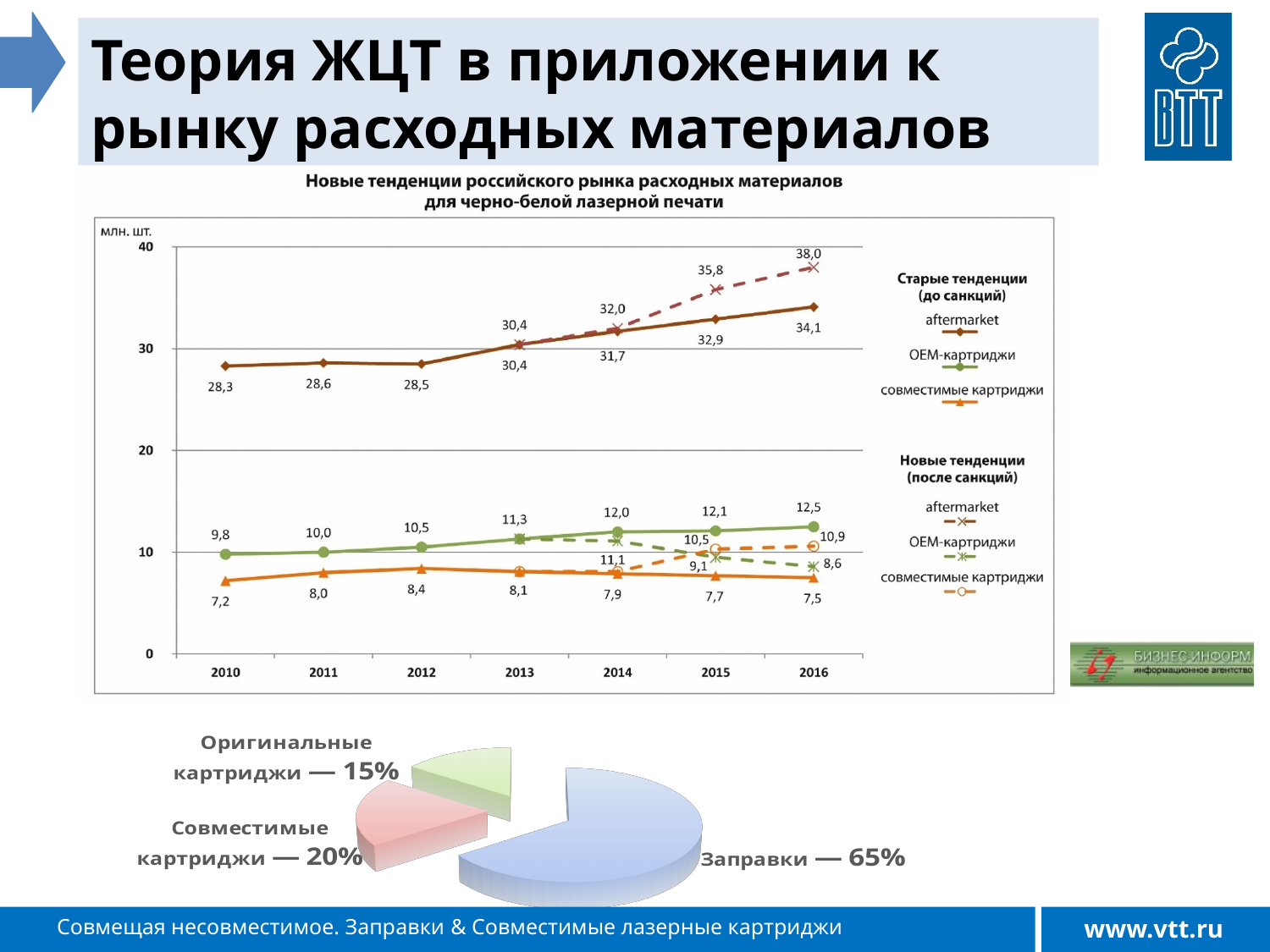
In the line chart, does the old-trend aftermarket series rise or fall from 2013 to 2016? rise In the line chart, what is the value for aftermarket (old trends, before sanctions) in 2010? 28,3 In the pie chart, what share do Заправки have? 65% What type of chart is the bottom chart on the slide? pie chart In the line chart, what is the difference between the new-trend aftermarket value (38,0) and the old-trend aftermarket value (34,1) in 2016? 3,9 In the line chart, what is the value for aftermarket (new trends, after sanctions) in 2016? 38,0 How many years are shown on the x axis of the line chart? 7 In the line chart, which is larger in 2016: the old-trend OEM-картриджи value or the new-trend OEM-картриджи value? old-trend OEM-картриджи (12,5) In the line chart, in which year is the old-trend aftermarket series highest? 2016 In the line chart, what is the value for совместимые картриджи (old trends) in 2012? 8,4 In the line chart, what is the value for OEM-картриджи (old trends) in 2013? 11,3 In the line chart, in which year is the old-trend совместимые картриджи series lowest? 2010